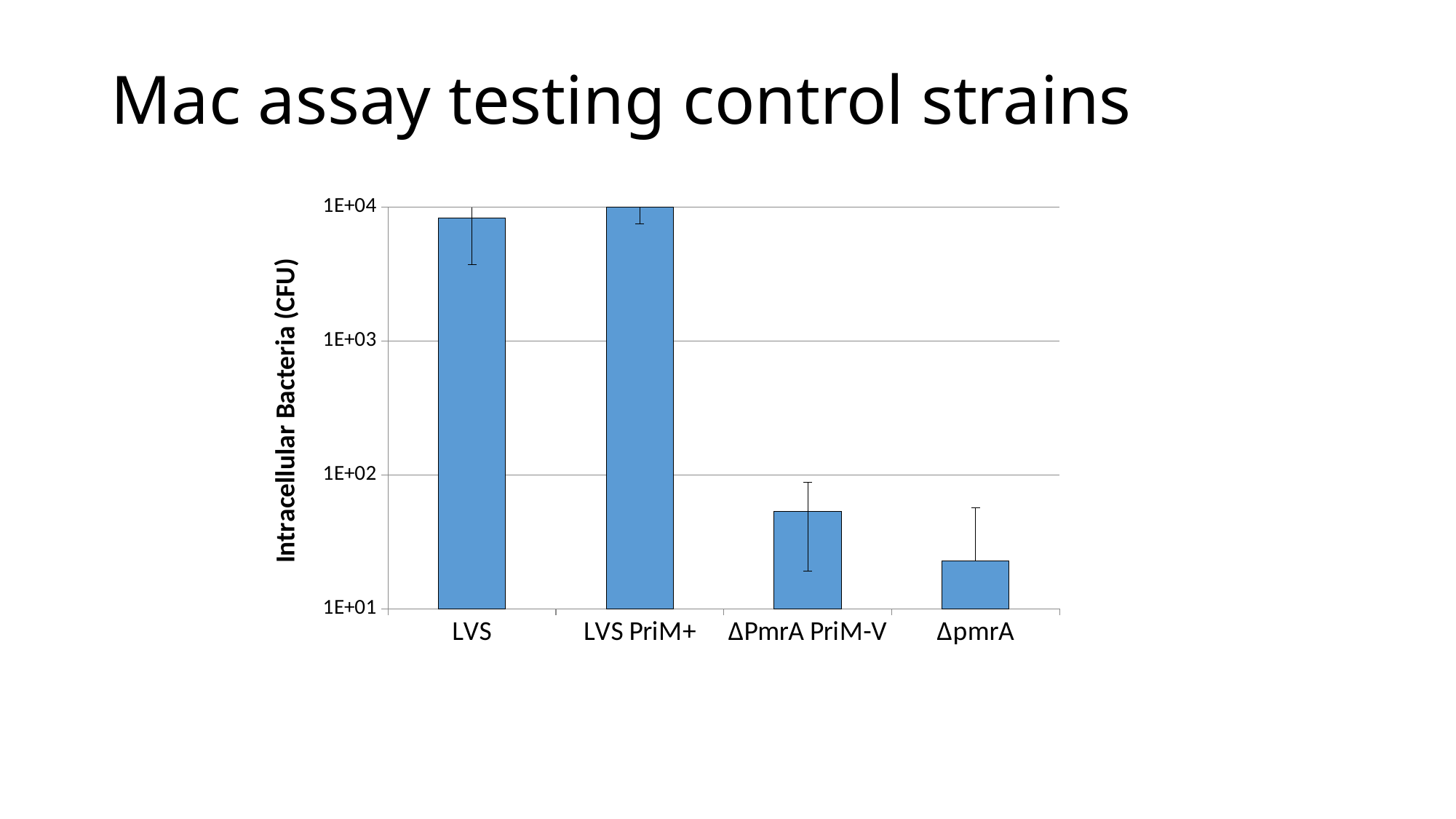
What is the label of the y axis? Intracellular Bacteria (CFU) Is the value for LVS greater or less than 1E+03? greater What kind of chart is shown on the slide? bar chart How many strains (categories) are plotted on the x axis? 4 Is the value for ΔPmrA PriM-V greater or less than 1E+02? less Which strain has the lowest intracellular bacteria count? ΔpmrA What is the title of the slide containing the chart? Mac assay testing control strains Is the value for ΔpmrA greater or less than 1E+02? less Which has a higher intracellular bacteria count, ΔPmrA PriM-V or ΔpmrA? ΔPmrA PriM-V Which has a higher intracellular bacteria count, LVS or ΔPmrA PriM-V? LVS Which strain has the highest intracellular bacteria count? LVS PriM+